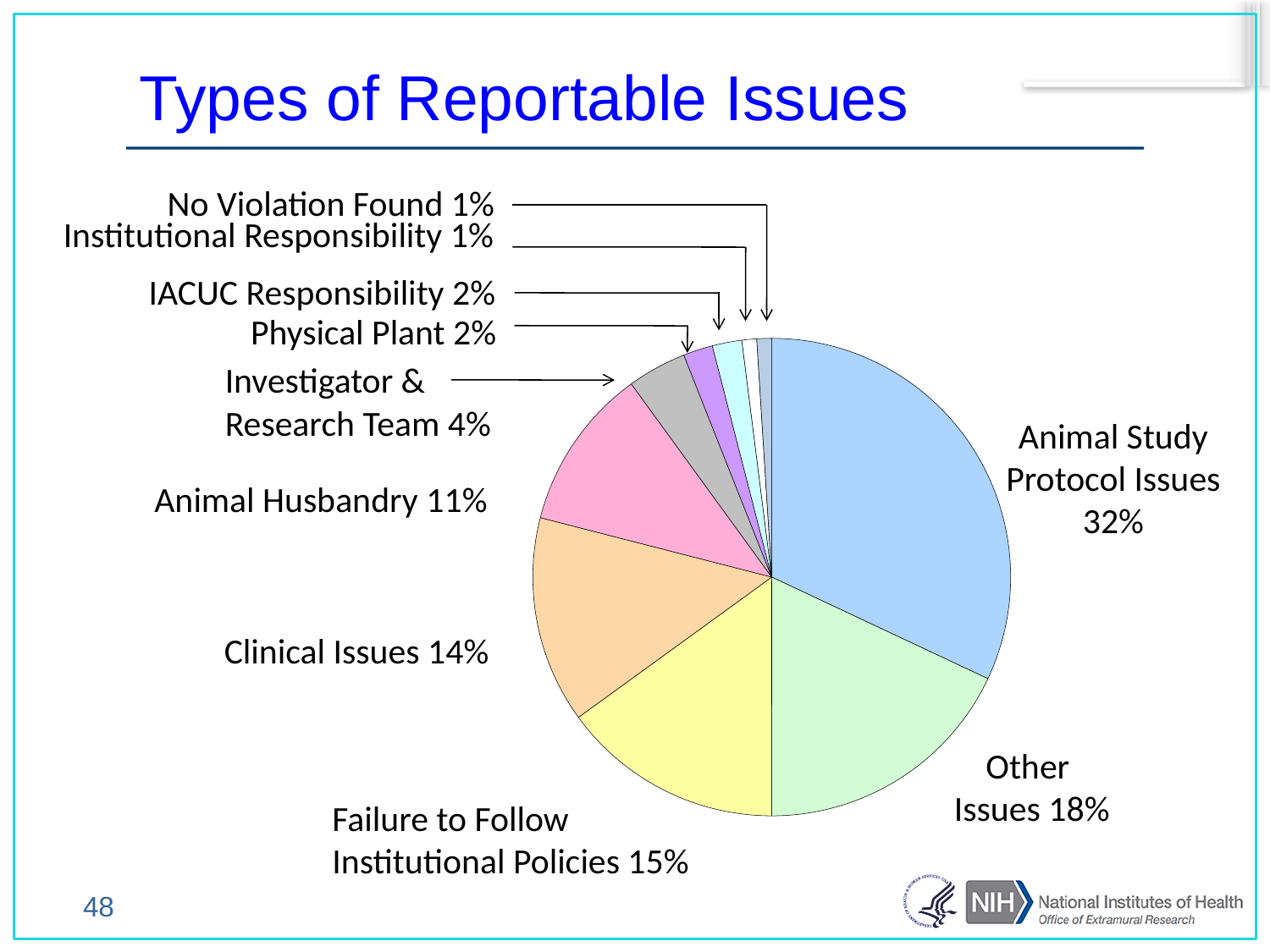
What share of the pie is Animal Study Protocol Issues? 32% How many slices does the pie chart have? 10 Which is larger, Clinical Issues or Animal Husbandry? Clinical Issues What is the difference in percentage points between Animal Study Protocol Issues and Other Issues? 14 What is the combined percentage of Physical Plant and IACUC Responsibility? 4% What percentage is shown for Failure to Follow Institutional Policies? 15% What percentage is shown for Animal Husbandry? 11% What percentage is shown for Investigator & Research Team? 4% What type of chart is shown on the slide? Pie chart What is the title of the chart? Types of Reportable Issues What percentage is shown for Clinical Issues? 14% Which category has the largest slice of the pie? Animal Study Protocol Issues